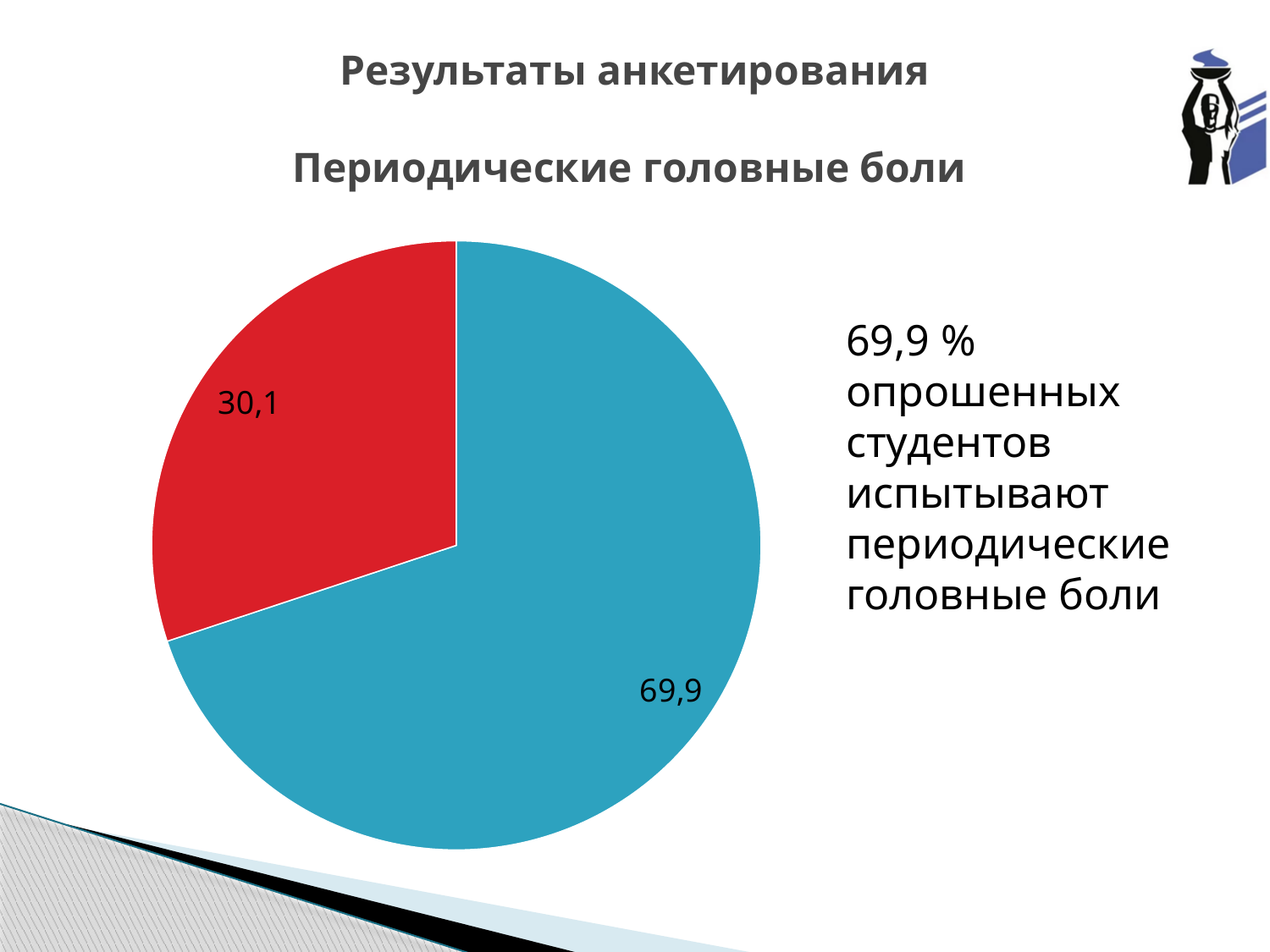
Which is larger, the blue slice or the red slice? the blue slice What is the title of the chart on the slide? Периодические головные боли What kind of chart is shown on the slide? pie chart What do the two slice values of the pie chart add up to? 100 What value is printed on the red slice of the pie chart? 30,1 According to the slide, what percentage of surveyed students experience periodic headaches? 69,9 % How many slices does the pie chart have? 2 Which slice of the pie chart is the smallest? the red slice (30,1) What is the difference between the blue slice value and the red slice value? 39,8 What value is printed on the blue slice of the pie chart? 69,9 Which slice of the pie chart is the largest? the blue slice (69,9) What share of the pie does the red slice represent? 30,1%